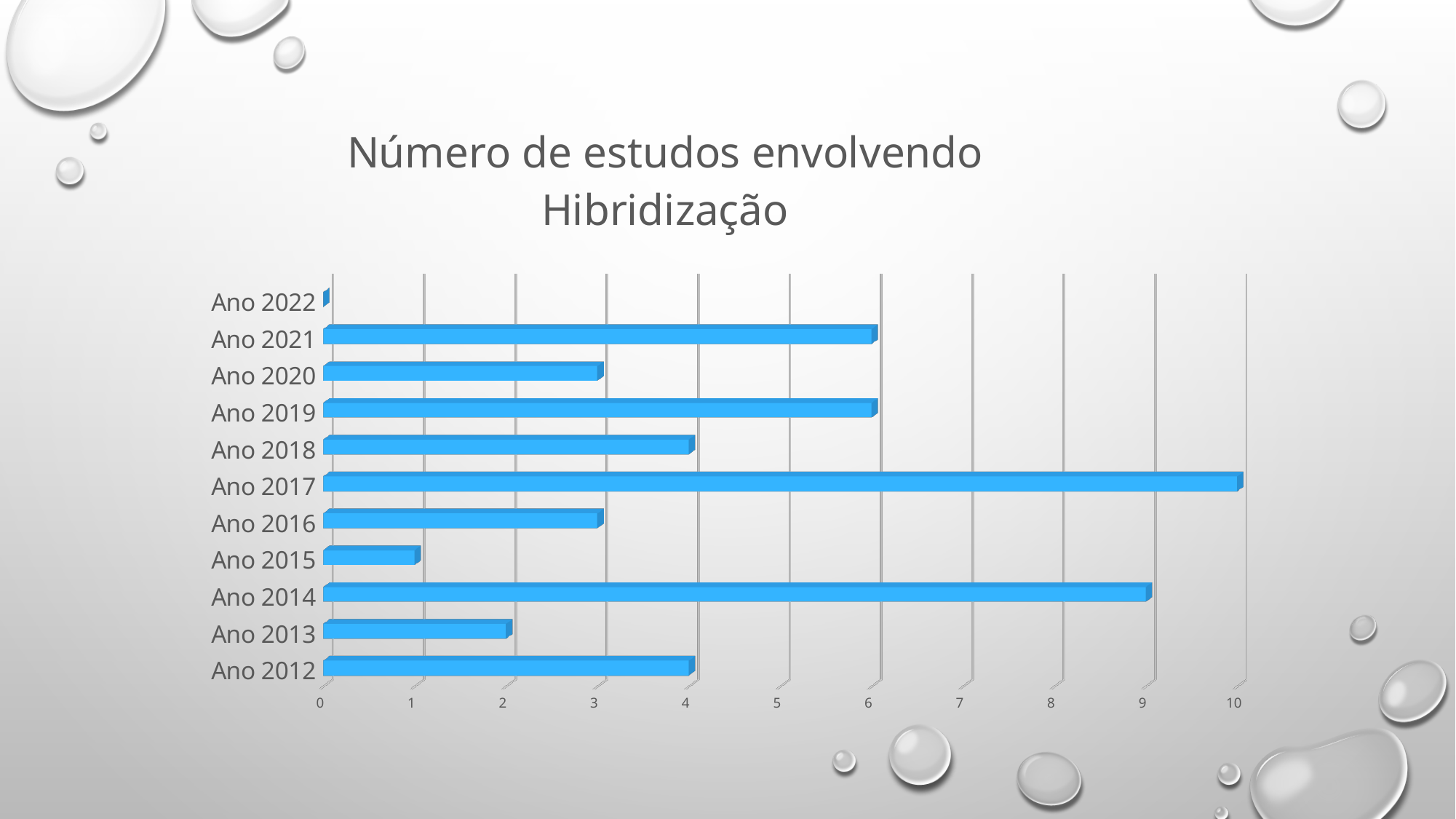
Is the value for Ano 2014 greater or less than 8? greater What is the value for Ano 2017? 10 What is the value for Ano 2014? 9 How many years (categories) are shown in the chart? 11 What kind of chart is shown on the slide? bar chart Which year has the highest number of studies? Ano 2017 What is the value for Ano 2013? 2 What is the value for Ano 2015? 1 Which is larger, the value for Ano 2021 or the value for Ano 2020? Ano 2021 What is the title of the chart? Número de estudos envolvendo Hibridização What is the difference between the values for Ano 2017 and Ano 2014? 1 Which year has the lowest number of studies? Ano 2022